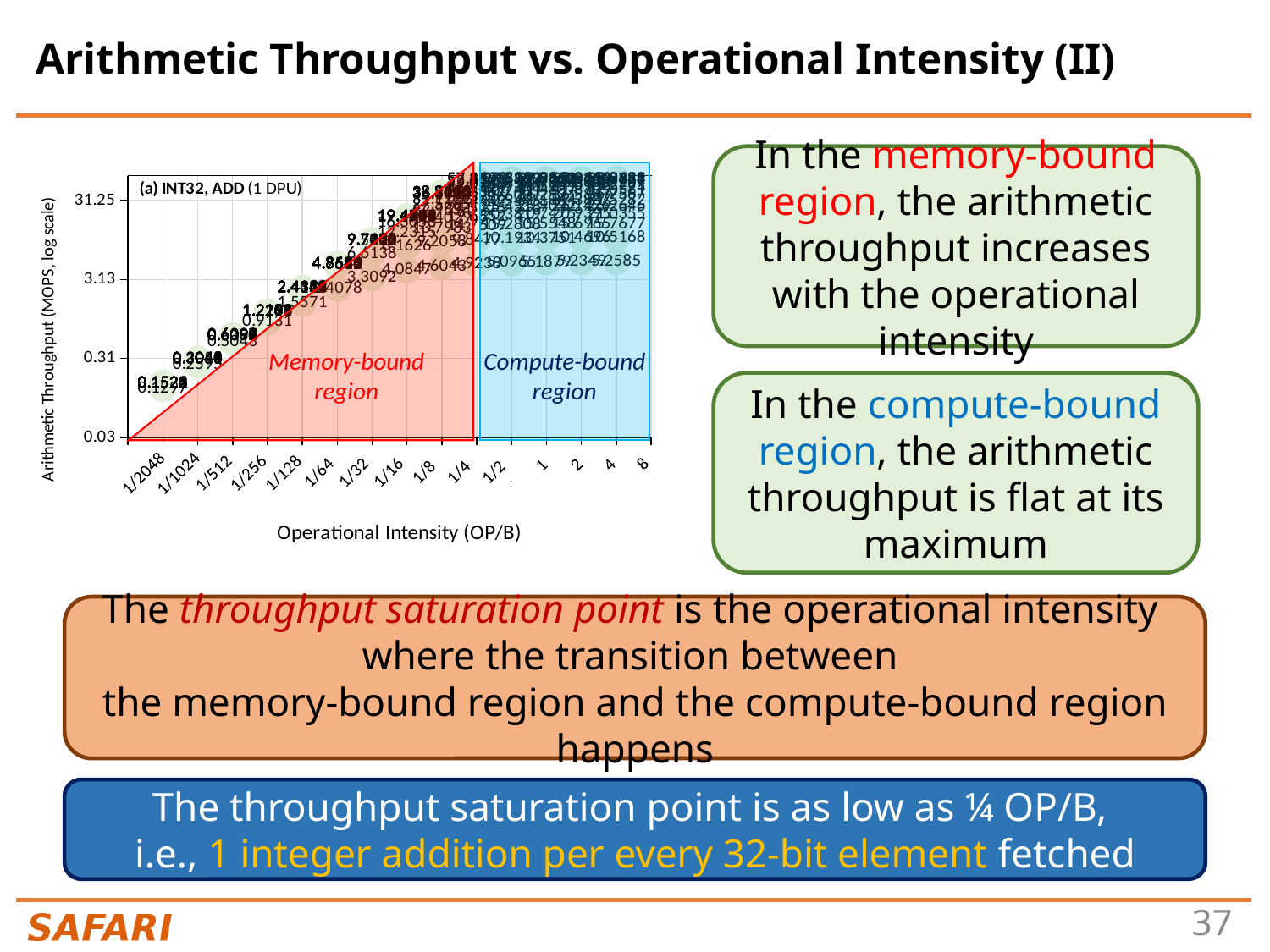
Is the arithmetic throughput at operational intensity 1/512 greater or less than 3.13? less What is the label of the x axis of the chart? Operational Intensity (OP/B) How many operational intensity values are marked on the x axis of the chart? 15 Which has the higher arithmetic throughput: operational intensity 1/1024 or operational intensity 8? 8 Is the arithmetic throughput at operational intensity 1/2048 greater or less than 0.31? less What kind of chart is shown on the slide? scatter chart Which operational intensity has the lowest arithmetic throughput in the chart? 1/2048 Does the arithmetic throughput rise, fall, or stay flat as operational intensity increases from 1/2 to 8? stay flat Is the arithmetic throughput at operational intensity 1/4 greater or less than 3.13? greater Does the arithmetic throughput rise or fall as operational intensity increases from 1/2048 to 1/4? rise What is the label of the y axis of the chart? Arithmetic Throughput (MOPS, log scale)